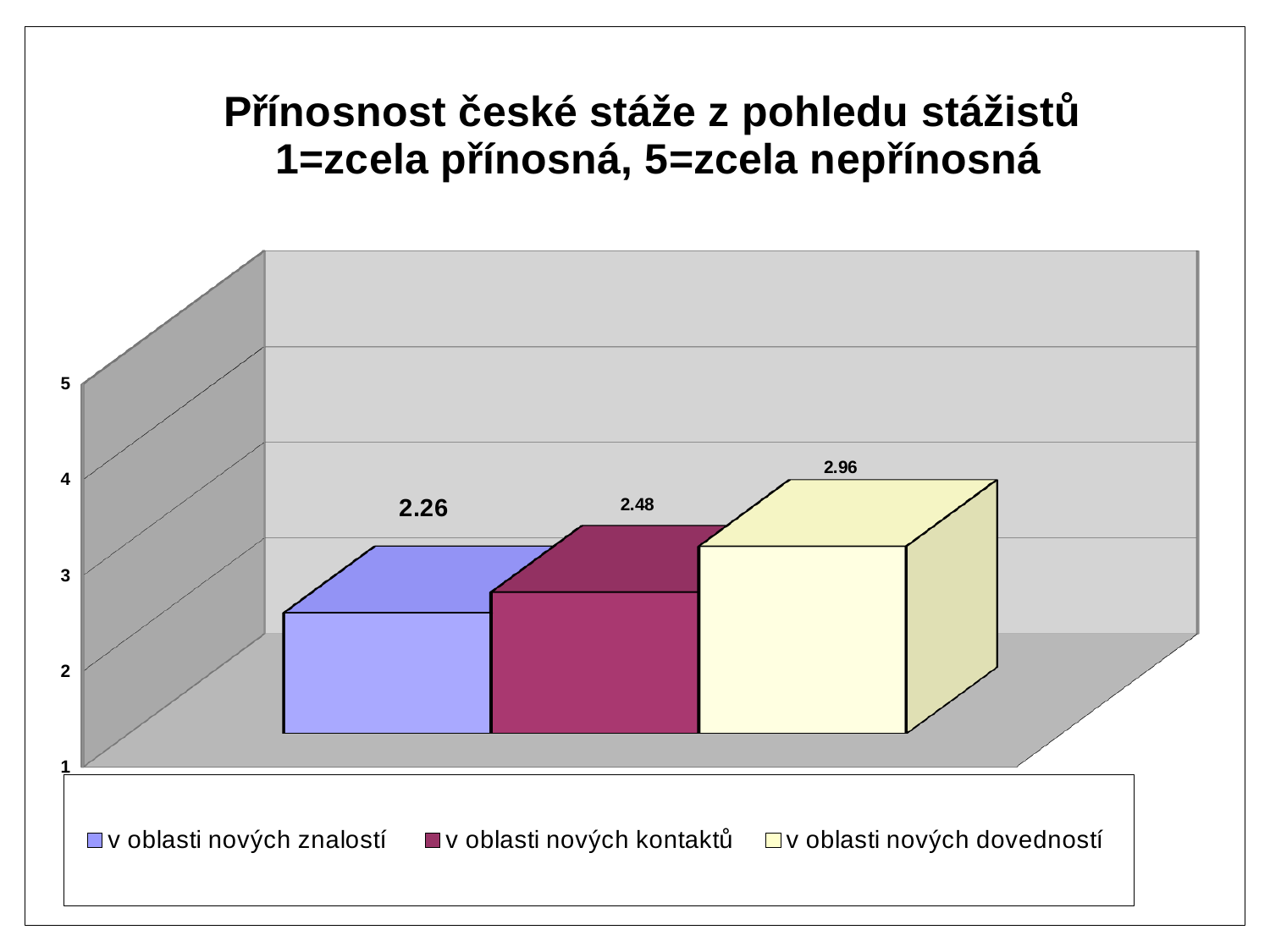
Which is larger: the value for 'v oblasti nových kontaktů' or 'v oblasti nových dovedností'? v oblasti nových dovedností What is the value for 'v oblasti nových dovedností'? 2.96 What is the difference between the values for 'v oblasti nových kontaktů' and 'v oblasti nových znalostí'? 0.22 Which series has the lowest value? v oblasti nových znalostí What colour is the bar for 'v oblasti nových kontaktů'? dark red / magenta Is the value for 'v oblasti nových dovedností' greater or less than 3? less What is the value for 'v oblasti nových kontaktů'? 2.48 What is the difference between the values for 'v oblasti nových dovedností' and 'v oblasti nových znalostí'? 0.70 What kind of chart is shown on the slide? bar chart Which series has the highest value? v oblasti nových dovedností What is the value for 'v oblasti nových znalostí'? 2.26 How many series does the legend list? 3